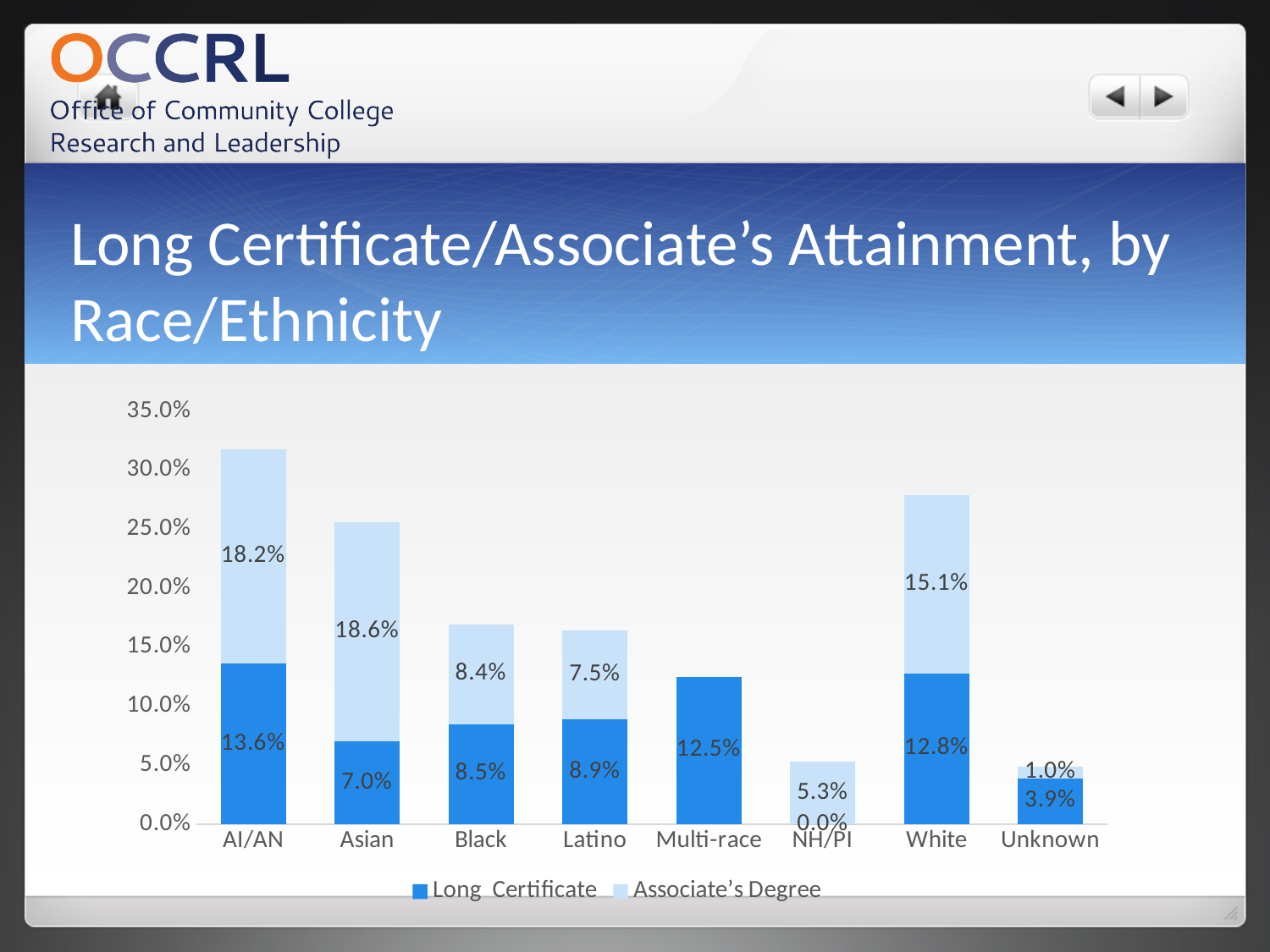
What is the total of the stacked bar for AI/AN? 31.8% What is the Associate's Degree value for NH/PI? 5.3% Which has the larger Long Certificate value, Black or Latino? Latino Is the total of the stacked bar for White greater or less than 25.0%? greater How many race/ethnicity categories are shown on the x axis? 8 What kind of chart is shown on the slide? Stacked bar chart How many series does the legend list? 2 What is the difference between the Associate's Degree and Long Certificate values for White? 2.3% What is the Long Certificate value for White? 12.8% What is the Associate's Degree value for Asian? 18.6% Which category has the highest Long Certificate value? AI/AN Which category has the lowest Long Certificate value? NH/PI